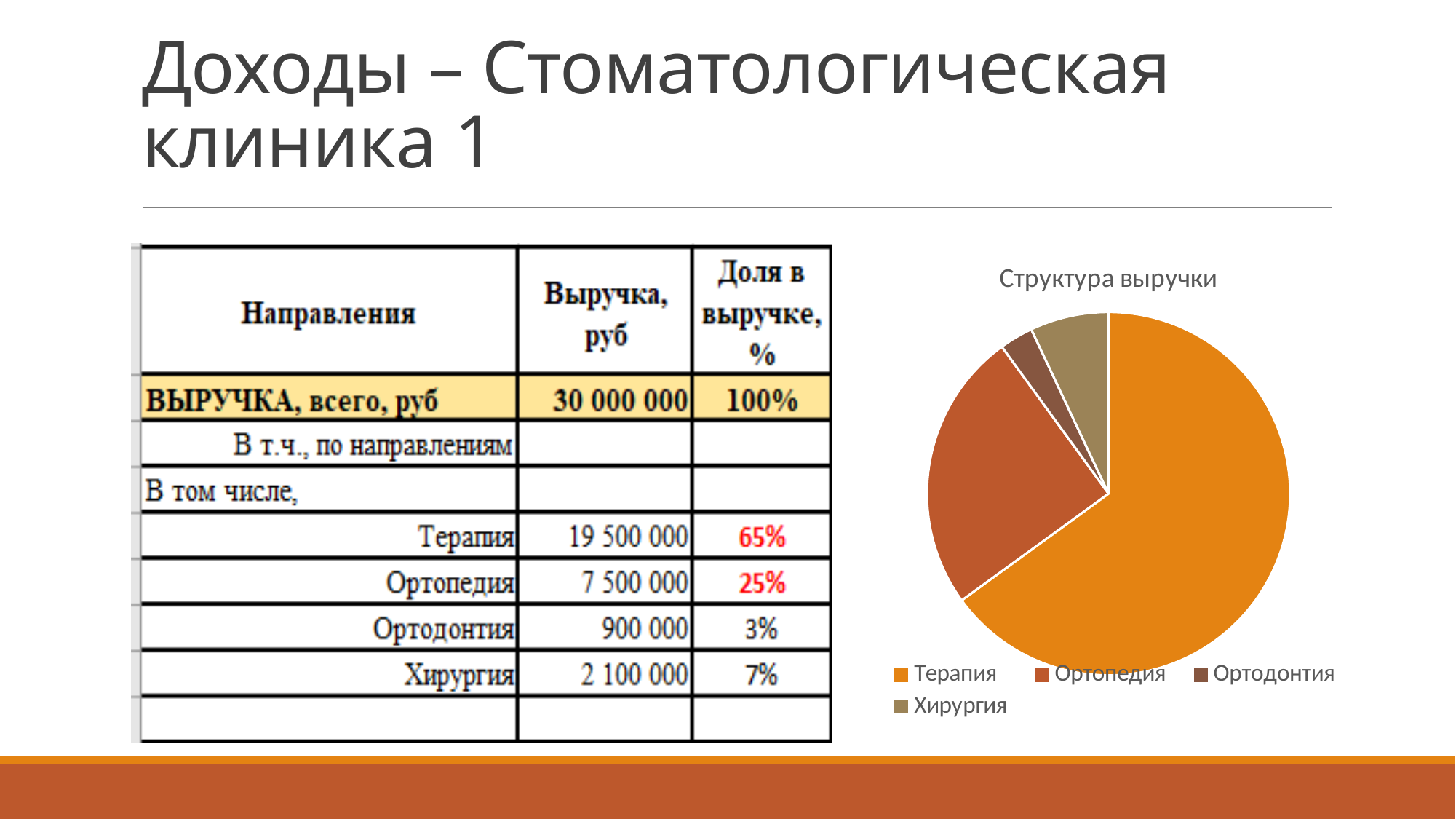
Which category has the largest slice in the pie chart? Терапия Which slice is larger in the pie chart, Ортопедия or Хирургия? Ортопедия What is the title of the pie chart? Структура выручки According to the slide, what share of revenue does Хирургия account for? 7% Which slice is larger in the pie chart, Хирургия or Ортодонтия? Хирургия How many slices does the pie chart have? 4 What kind of chart is shown on the slide? pie chart According to the slide, what share of revenue does Ортопедия account for? 25% Which category is shown in the lightest (tan) colour in the pie chart? Хирургия According to the slide, what share of revenue does Терапия account for? 65% Which category has the smallest slice in the pie chart? Ортодонтия How many categories does the legend of the pie chart list? 4